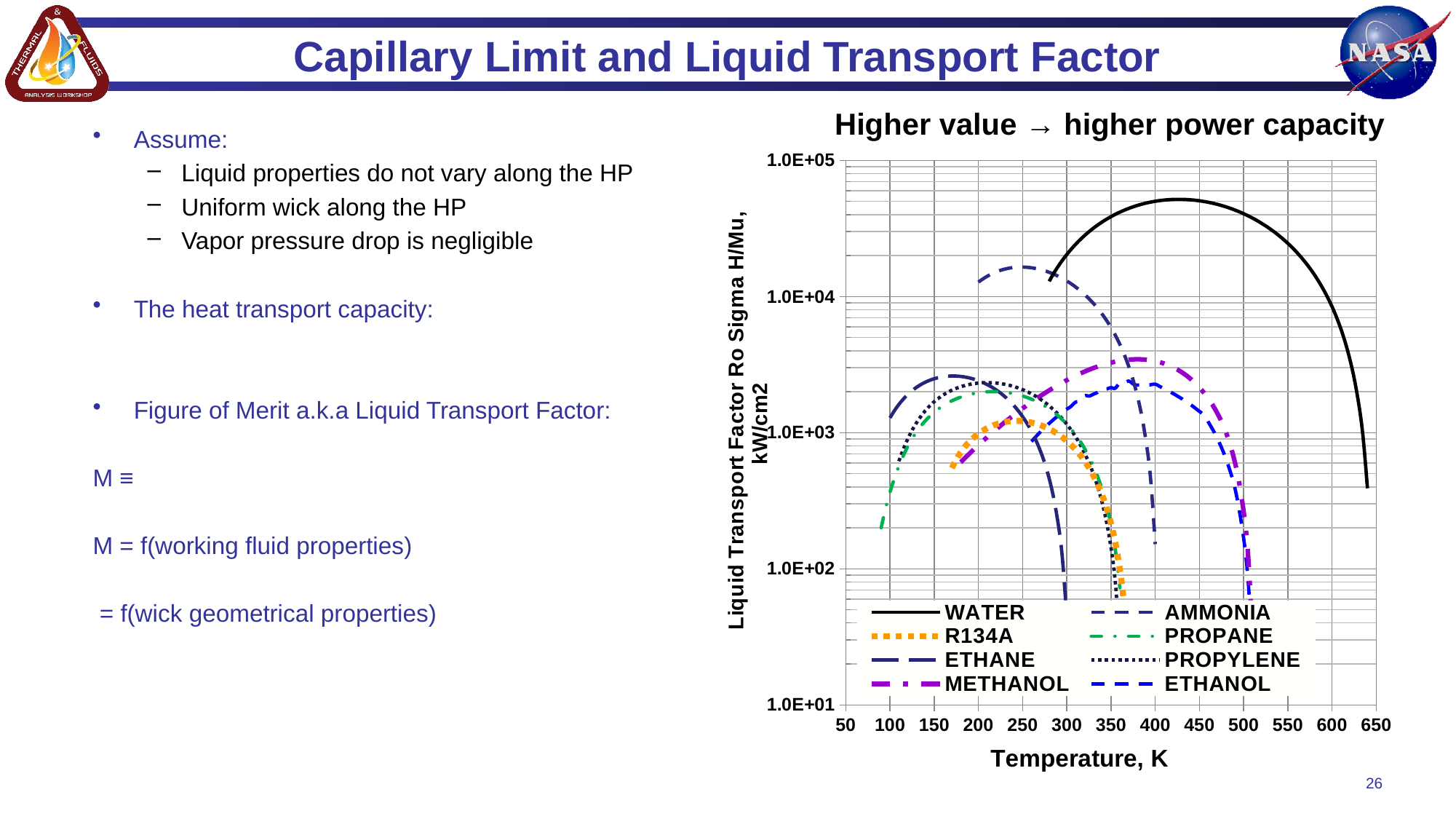
Which working fluid reaches the highest liquid transport factor on the chart? WATER Is the peak value for AMMONIA greater or less than 1.0E+04? greater Which fluid has a higher peak liquid transport factor, WATER or AMMONIA? WATER How many series does the legend of the chart list? 8 Which fluid has a higher peak liquid transport factor, AMMONIA or ETHANOL? AMMONIA Which working fluid has the lowest peak liquid transport factor on the chart? R134A Is the peak value for METHANOL greater or less than 1.0E+03? greater What kind of chart is shown on the slide? line chart Is the peak value for R134A greater or less than 1.0E+04? less What heading is printed above the chart? Higher value → higher power capacity What is the label of the x axis of the chart? Temperature, K